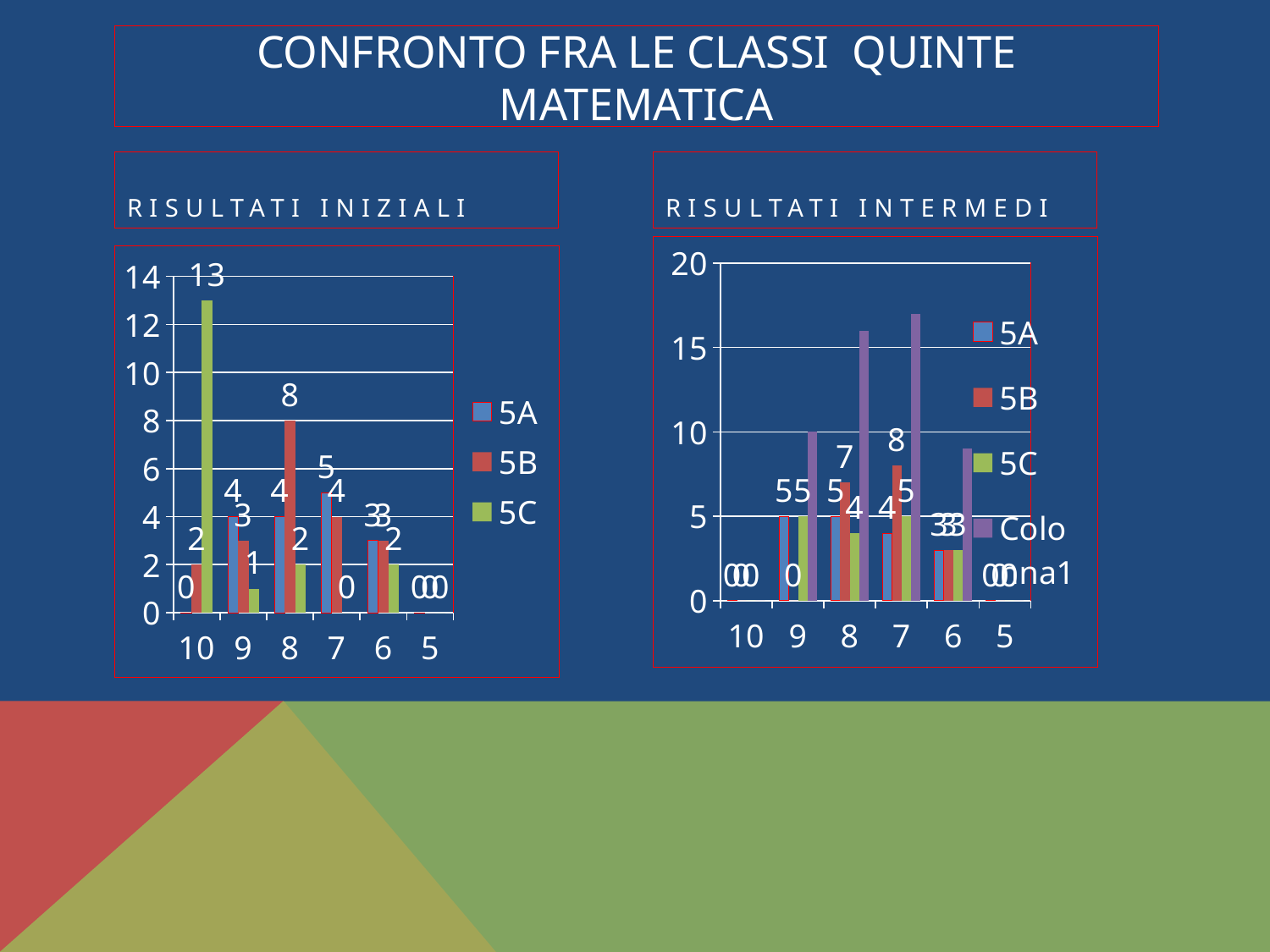
In the RISULTATI INTERMEDI chart, what is the value for 5B at category 7? 8 How many series does the legend of the RISULTATI INIZIALI chart list? 3 In the RISULTATI INIZIALI chart, what is the value for 5C at category 10? 13 In the RISULTATI INTERMEDI chart, is the value for Colonna1 at category 7 greater or less than 15? greater In the RISULTATI INIZIALI chart, what is the value for 5A at category 7? 5 In the RISULTATI INIZIALI chart, which series has the highest value at category 10? 5C In the RISULTATI INIZIALI chart, which is larger at category 9: 5A or 5B? 5A In the RISULTATI INIZIALI chart, what is the value for 5B at category 8? 8 What kind of chart is the RISULTATI INTERMEDI chart? bar chart How many categories are shown on the x axis of the RISULTATI INTERMEDI chart? 6 How many series does the legend of the RISULTATI INTERMEDI chart list? 4 In the RISULTATI INIZIALI chart, what is the difference between 5B and 5A at category 8? 4